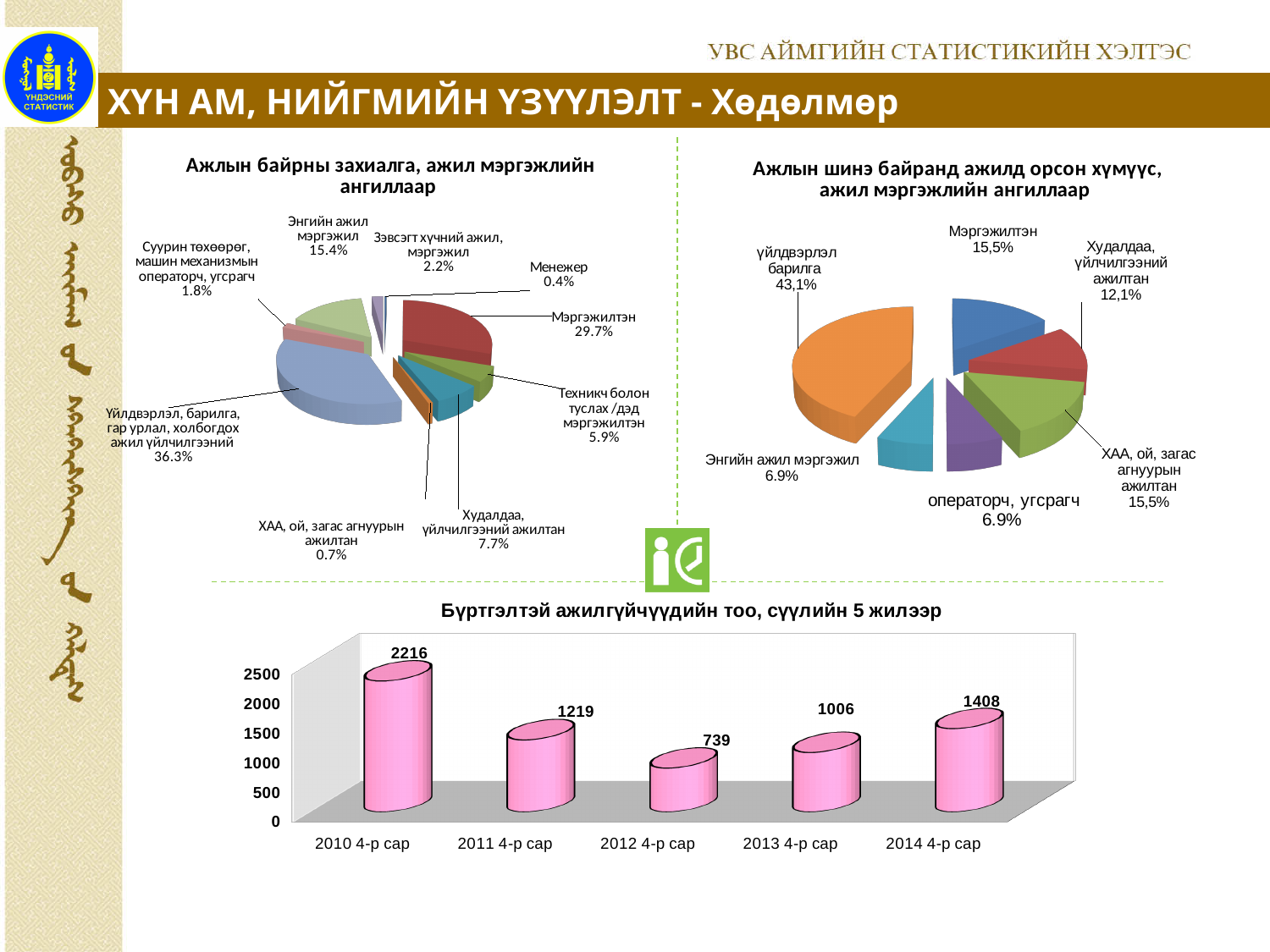
In the bar chart 'Бүртгэлтэй ажилгүйчүүдийн тоо, сүүлийн 5 жилээр', which period has the lowest value? 2012 4-р сар In the pie chart 'Ажлын байрны захиалга, ажил мэргэжлийн ангиллаар', what share does Мэргэжилтэн have? 29.7% In the pie chart 'Ажлын шинэ байранд ажилд орсон хүмүүс, ажил мэргэжлийн ангиллаар', which category has the largest share? үйлдвэрлэл барилга What kind of chart is 'Бүртгэлтэй ажилгүйчүүдийн тоо, сүүлийн 5 жилээр'? Bar chart In the bar chart 'Бүртгэлтэй ажилгүйчүүдийн тоо, сүүлийн 5 жилээр', what is the difference between the values for 2010 4-р сар and 2011 4-р сар? 997 In the bar chart 'Бүртгэлтэй ажилгүйчүүдийн тоо, сүүлийн 5 жилээр', which is larger: the value for 2013 4-р сар or 2014 4-р сар? 2014 4-р сар In the pie chart 'Ажлын байрны захиалга, ажил мэргэжлийн ангиллаар', which category has the smallest share? Менежер In the pie chart 'Ажлын байрны захиалга, ажил мэргэжлийн ангиллаар', which category has the largest share? Үйлдвэрлэл, барилга, гар урлал, холбогдох ажил үйлчилгээний How many periods are shown in the bar chart 'Бүртгэлтэй ажилгүйчүүдийн тоо, сүүлийн 5 жилээр'? 5 In the pie chart 'Ажлын шинэ байранд ажилд орсон хүмүүс, ажил мэргэжлийн ангиллаар', what share does Худалдаа, үйлчилгээний ажилтан have? 12,1% In the bar chart 'Бүртгэлтэй ажилгүйчүүдийн тоо, сүүлийн 5 жилээр', which period has the highest value? 2010 4-р сар In the bar chart 'Бүртгэлтэй ажилгүйчүүдийн тоо, сүүлийн 5 жилээр', what is the value for 2012 4-р сар? 739